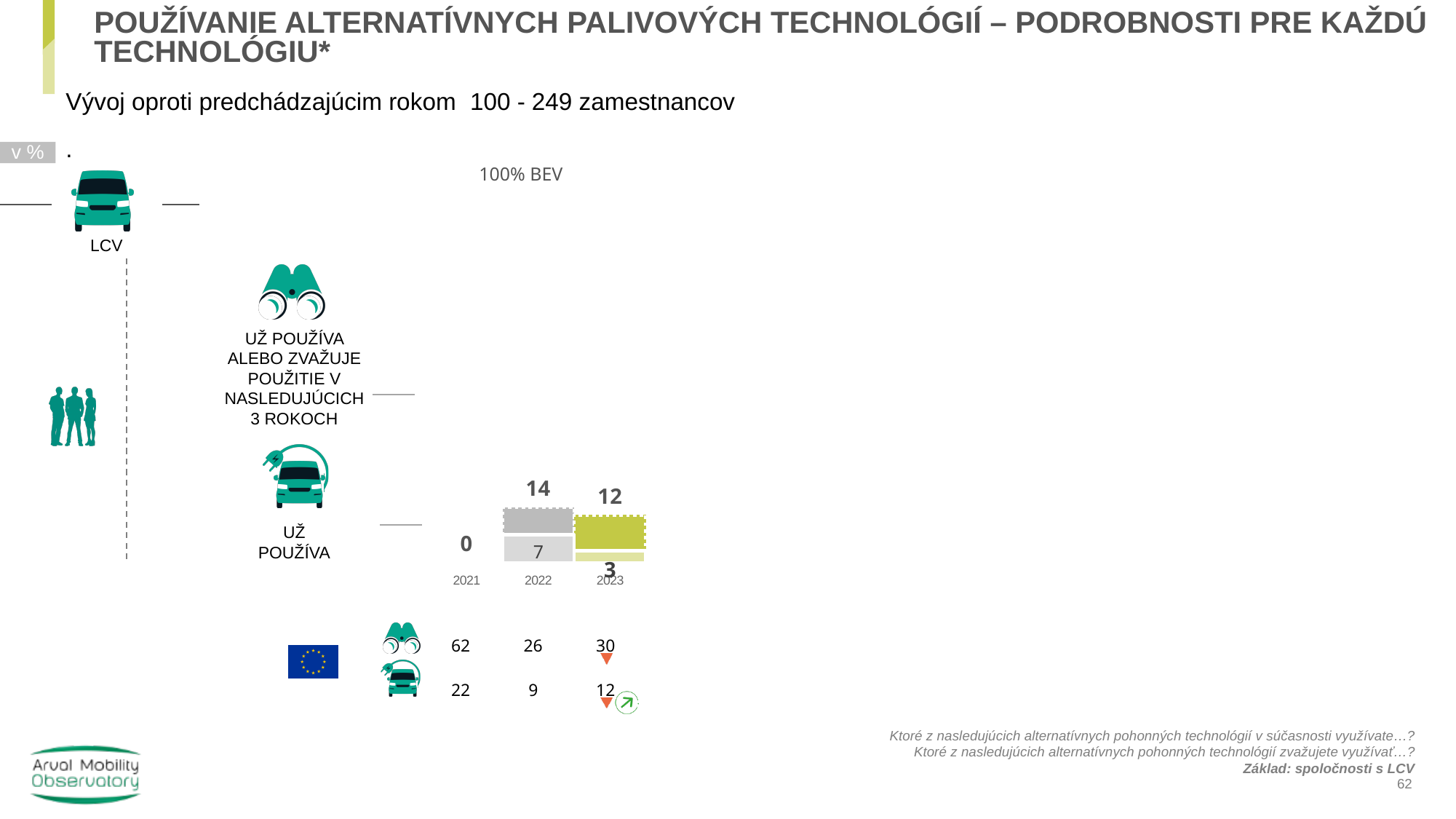
In the 100% BEV chart, what is the value for 2023 for 'už používa alebo zvažuje použitie v nasledujúcich 3 rokoch'? 12 In the 100% BEV chart, what is the difference between the 2022 and 2023 values for 'už používa'? 4 What kind of chart is the 100% BEV chart? bar chart In the 100% BEV chart, what is the value for 2023 for 'už používa'? 3 In the 100% BEV chart, what is the value for 2022 for 'už používa alebo zvažuje použitie v nasledujúcich 3 rokoch'? 14 In the 100% BEV chart, is the 'už používa' value larger in 2022 or in 2023? 2022 In the 100% BEV chart, what is the value shown for 2021? 0 In the 100% BEV chart, what is the value for 2022 for 'už používa'? 7 How many years are shown on the x axis of the 100% BEV chart? 3 In the 100% BEV chart, which year has the highest value for 'už používa alebo zvažuje použitie v nasledujúcich 3 rokoch'? 2022 In the EU reference row below the chart, what is the 2023 value for 'už používa'? 12 In the 100% BEV chart, what is the difference between the 2022 and 2023 values for 'už používa alebo zvažuje použitie v nasledujúcich 3 rokoch'? 2